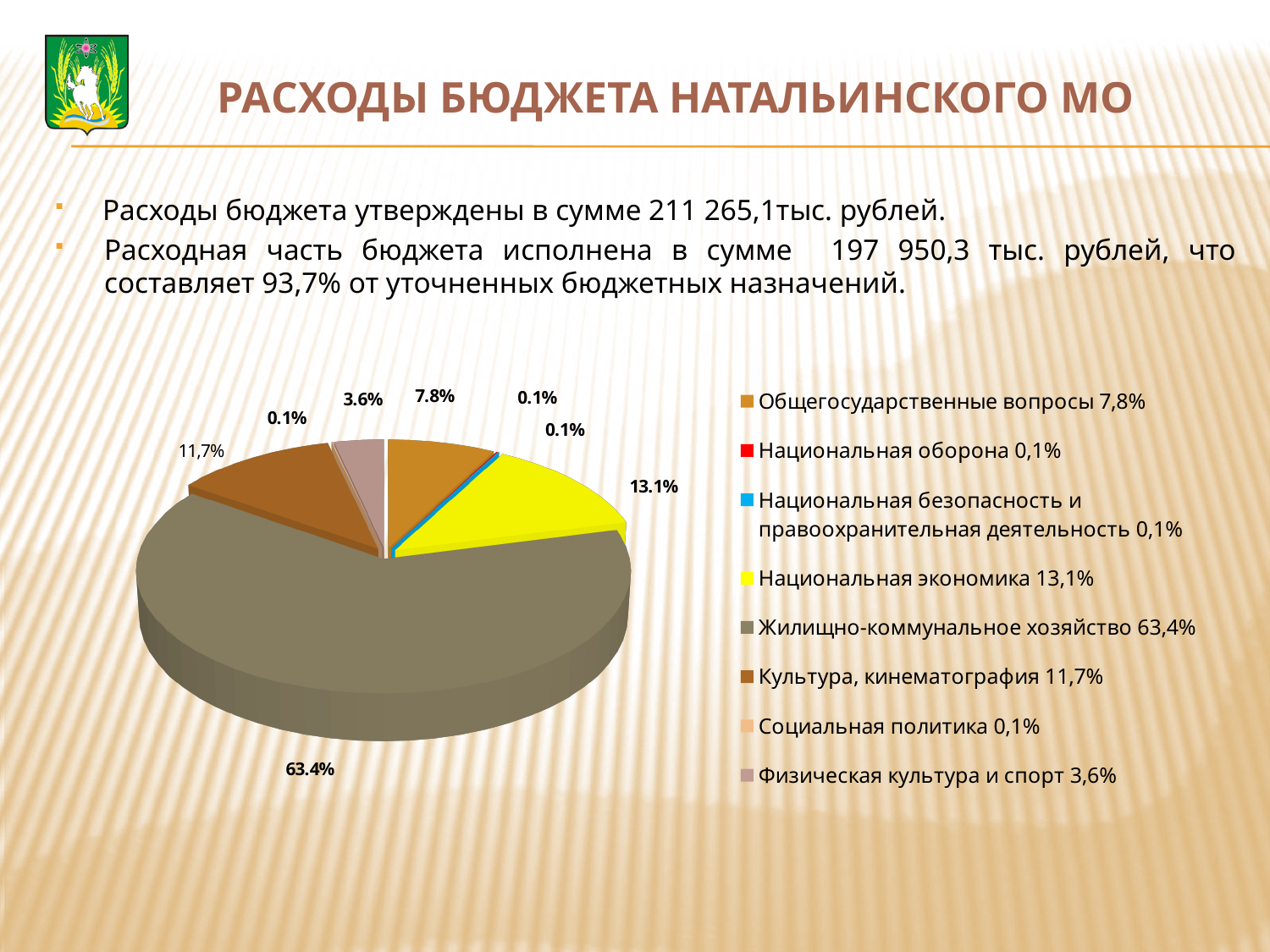
What colour is the slice for Национальная экономика? Yellow How many categories does the pie chart have? 8 What is the value shown for Общегосударственные вопросы? 7.8% What is the value shown for Национальная оборона? 0.1% What kind of chart is shown on the slide? Pie chart What is the value shown for Физическая культура и спорт? 3.6% What is the value shown for Национальная экономика? 13.1% What share of the pie does Жилищно-коммунальное хозяйство have? 63.4% Which is larger: the share of Национальная экономика or the share of Культура, кинематография? Национальная экономика Which category has the largest slice of the pie? Жилищно-коммунальное хозяйство What is the value shown for Культура, кинематография? 11,7% What is the difference between the shares of Жилищно-коммунальное хозяйство and Национальная экономика? 50.3%